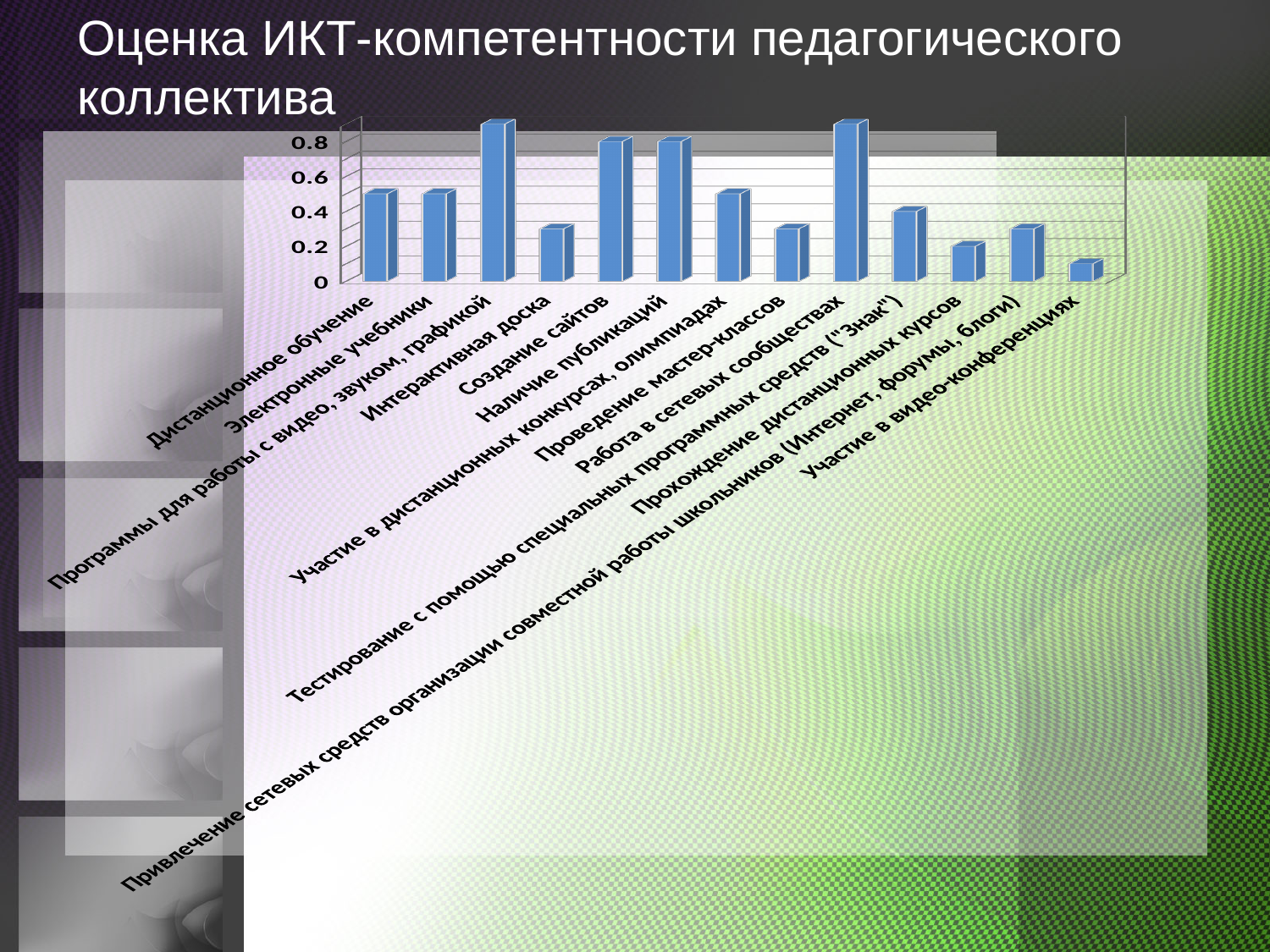
Which is larger, the value for Наличие публикаций or the value for Проведение мастер-классов? Наличие публикаций Is the value for Прохождение дистанционных курсов greater or less than 0.4? less How many categories are plotted in the chart? 13 Is the value for Создание сайтов greater or less than 0.6? greater What kind of chart is shown on the slide? bar chart What is the title of the slide containing the chart? Оценка ИКТ-компетентности педагогического коллектива Is the value for Программы для работы с видео, звуком, графикой greater or less than 0.8? greater What is the highest tick value shown on the vertical axis of the chart? 0.8 Which is larger, the value for Работа в сетевых сообществах or the value for Тестирование с помощью специальных программных средств ("Знак")? Работа в сетевых сообществах Which category has the lowest value in the chart? Участие в видео-конференциях